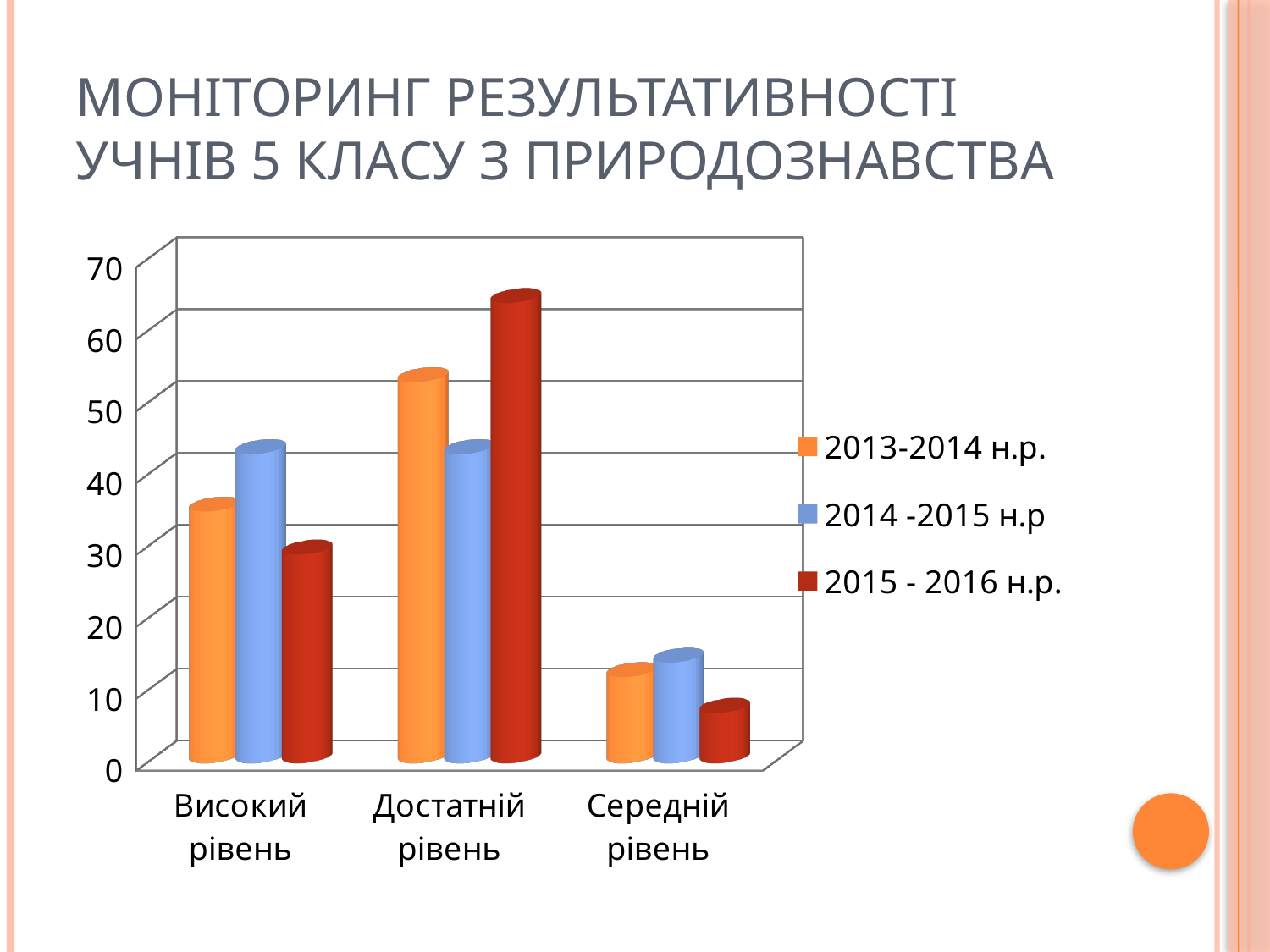
What kind of chart is shown on the slide? bar chart How many series does the chart's legend list? 3 Is the value for 2013-2014 н.р. at Високий рівень greater or less than 40? less Which series has the lowest value for Середній рівень? 2015 - 2016 н.р. For Високий рівень, which is larger: the value for 2013-2014 н.р. or for 2014 -2015 н.р? 2014 -2015 н.р Is the value for 2015 - 2016 н.р. at Середній рівень greater or less than 10? less What is the title of the slide containing the chart? Моніторинг результативності учнів 5 класу з природознавства Is the value for 2015 - 2016 н.р. at Достатній рівень greater or less than 60? greater Which category has the highest value for 2013-2014 н.р.? Достатній рівень Which series has the highest value for Достатній рівень? 2015 - 2016 н.р. How many categories are shown on the x axis of the chart? 3